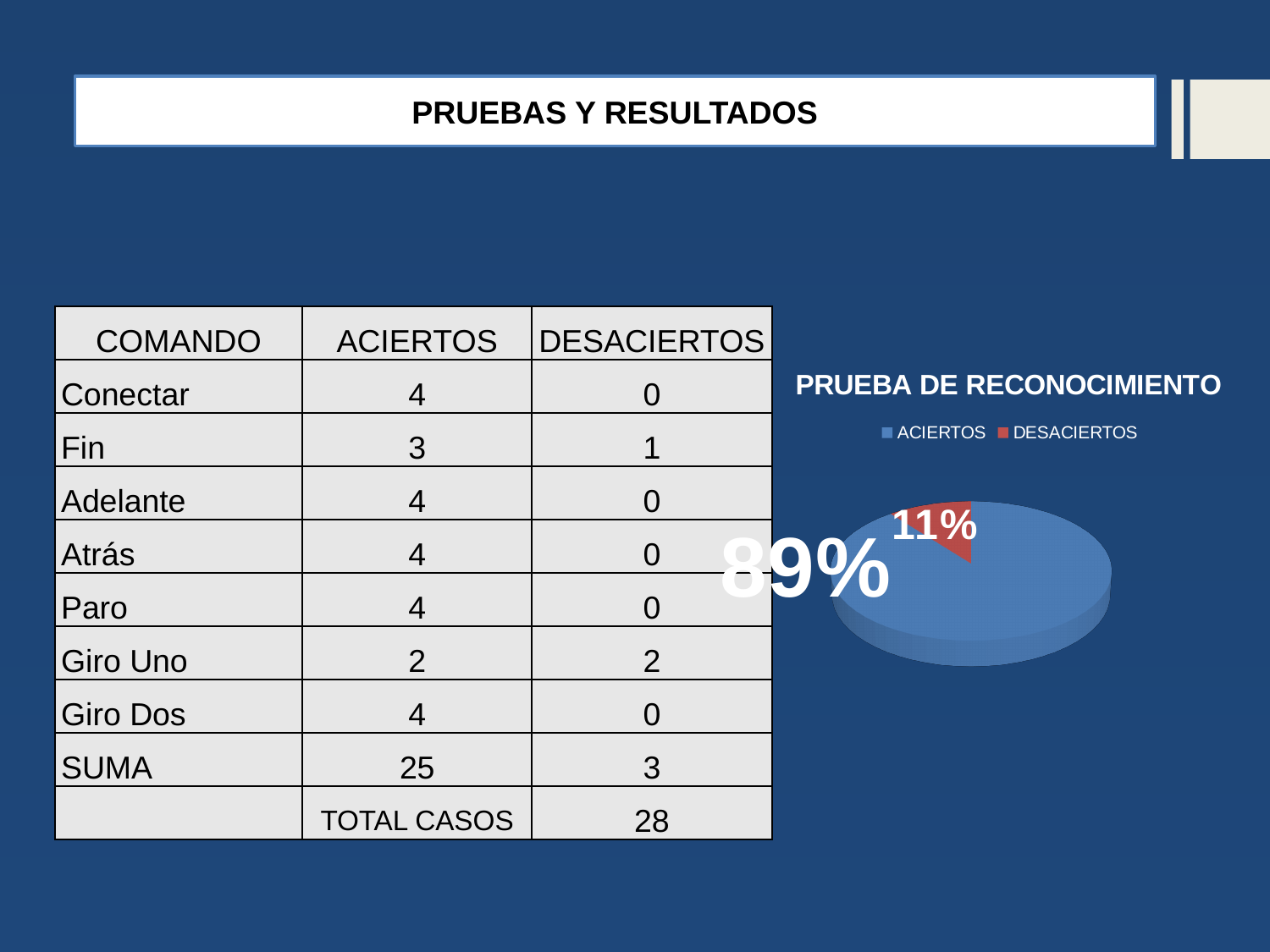
How many entries does the legend of the pie chart list? 2 Which slice of the pie chart is the largest? ACIERTOS What is the title of the pie chart? PRUEBA DE RECONOCIMIENTO How many slices does the pie chart have? 2 What colour is the DESACIERTOS slice in the pie chart? red What kind of chart is shown on the slide? pie chart What is the difference in percentage points between the ACIERTOS and DESACIERTOS slices? 78% What share of the pie chart does DESACIERTOS represent? 11% Which is larger in the pie chart, ACIERTOS or DESACIERTOS? ACIERTOS What share of the pie chart does ACIERTOS represent? 89% Which slice of the pie chart is the smallest? DESACIERTOS